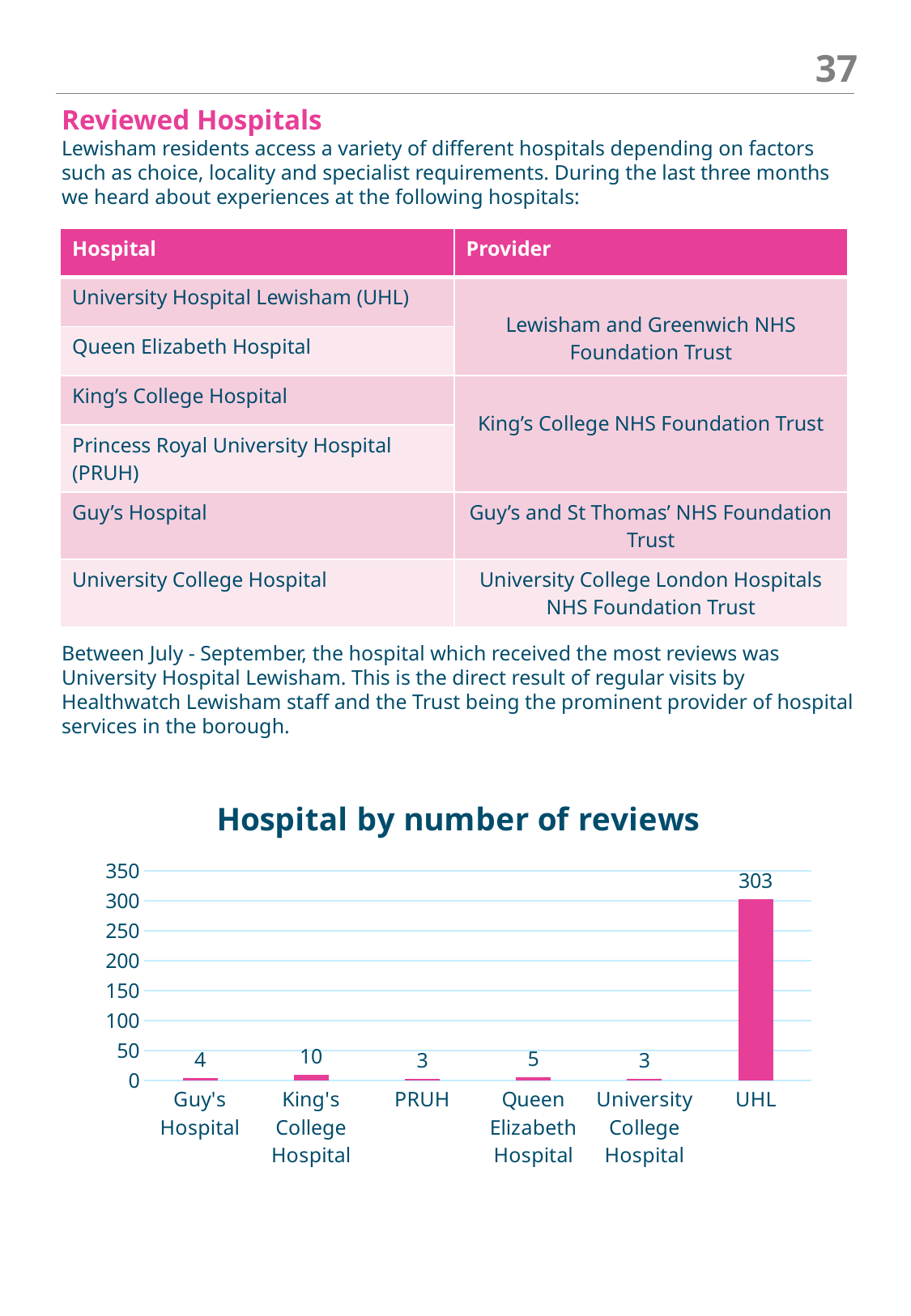
Is the value for UHL greater or less than 300? greater What is the number of reviews for Queen Elizabeth Hospital? 5 What kind of chart is shown on the slide? Bar chart What is the number of reviews for UHL? 303 What is the number of reviews for Guy's Hospital? 4 What is the number of reviews for King's College Hospital? 10 What is the difference in number of reviews between Guy's Hospital and PRUH? 1 What is the difference in number of reviews between UHL and King's College Hospital? 293 How many hospitals are shown in the chart? 6 What is the title of the chart? Hospital by number of reviews Which has more reviews, King's College Hospital or Queen Elizabeth Hospital? King's College Hospital Which hospital has the highest number of reviews? UHL